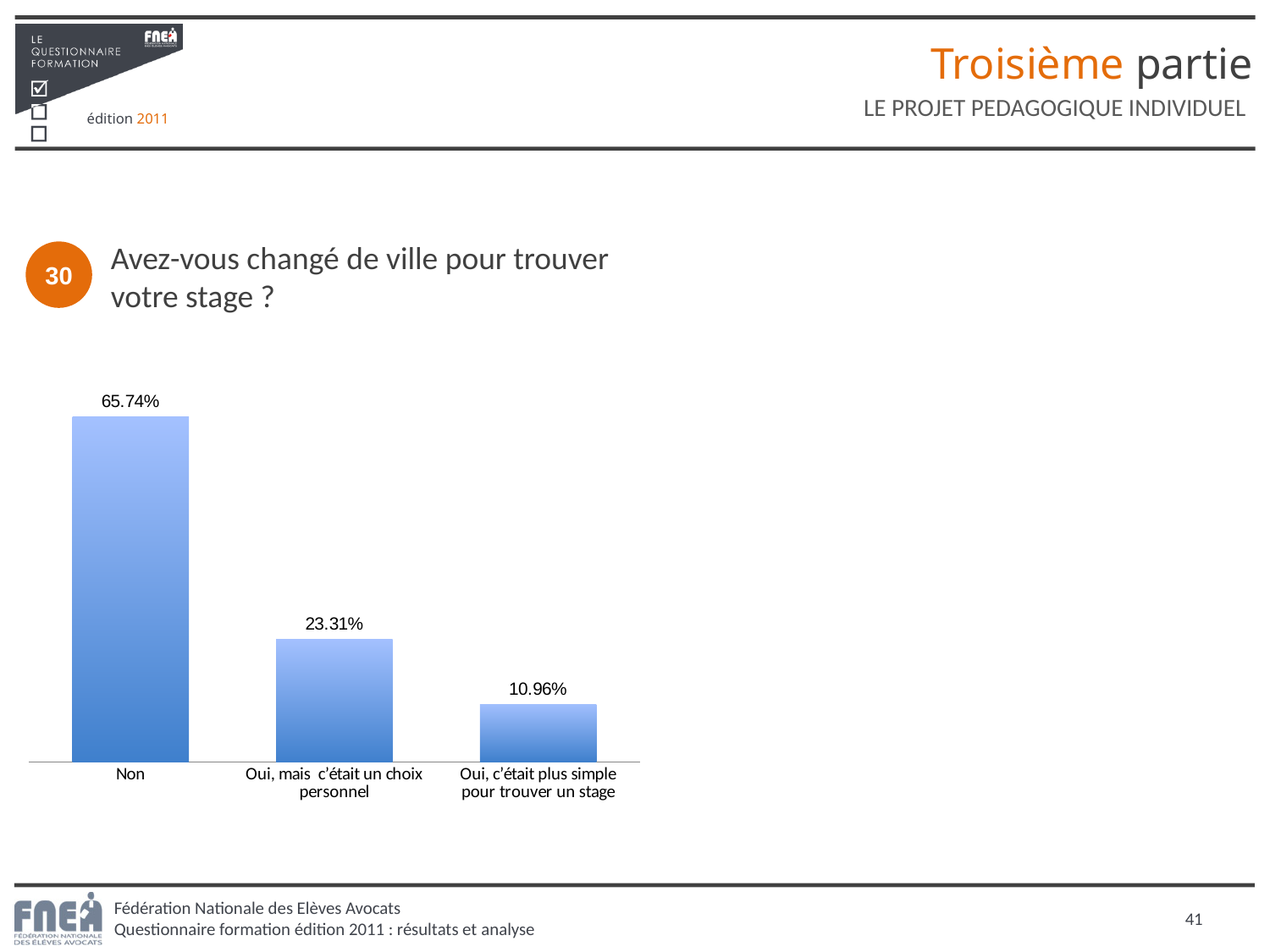
How many response categories are shown in the chart? 3 What is the value for "Oui, mais c'était un choix personnel"? 23.31% What type of chart is shown on the slide? Bar chart What is the difference between the "Non" value and the "Oui, mais c'était un choix personnel" value? 42.43% Which response category has the highest value? Non Which response category has the lowest value? Oui, c'était plus simple pour trouver un stage Which is larger: the value for "Oui, mais c'était un choix personnel" or for "Oui, c'était plus simple pour trouver un stage"? Oui, mais c'était un choix personnel What is the value for "Oui, c'était plus simple pour trouver un stage"? 10.96% What survey question does the chart on the slide answer? Avez-vous changé de ville pour trouver votre stage ? Do the bar values rise or fall from left to right across the categories? Fall What percentage of respondents answered "Non"? 65.74% What is the difference between "Oui, mais c'était un choix personnel" and "Oui, c'était plus simple pour trouver un stage"? 12.35%